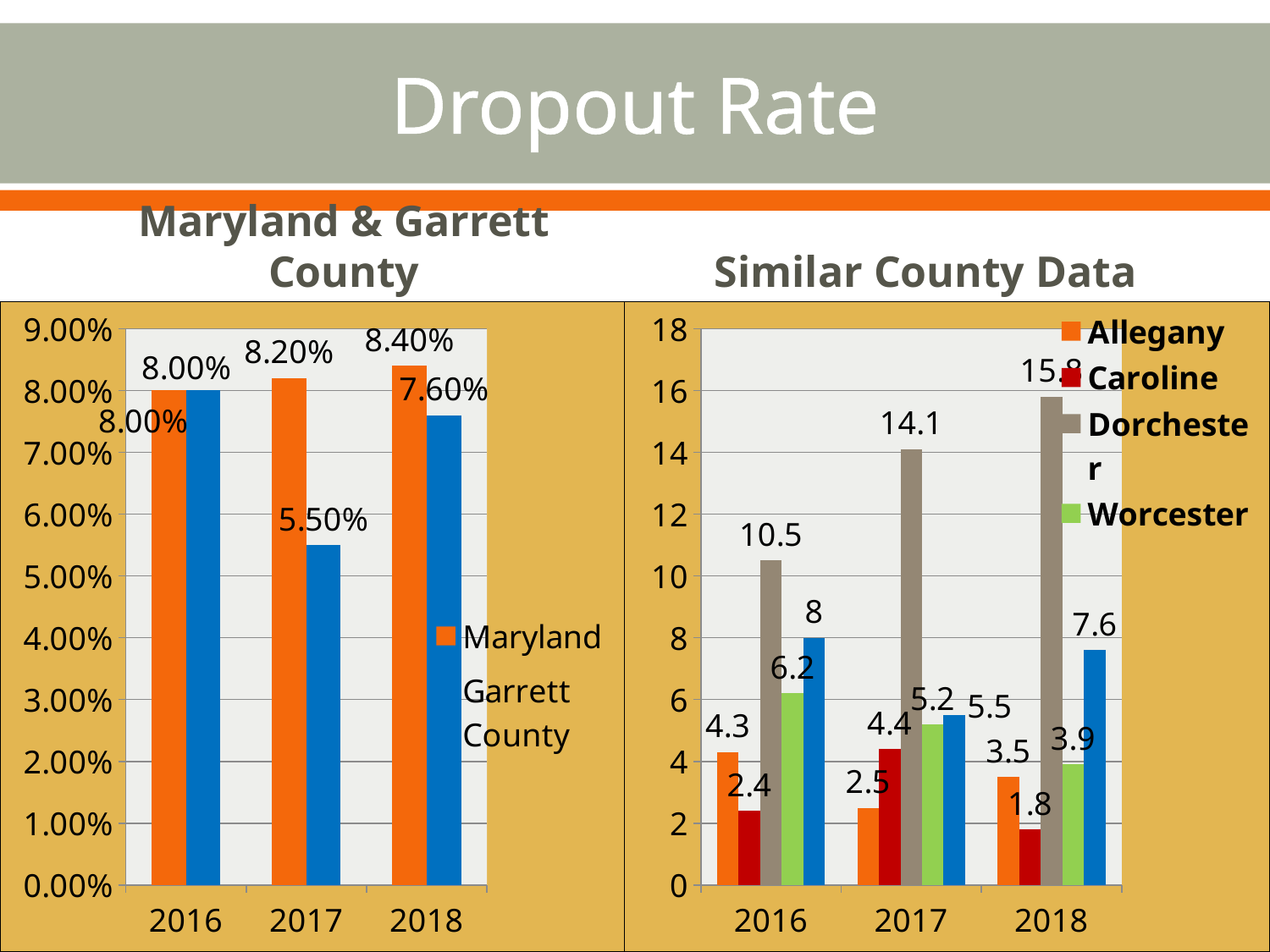
In the Similar County Data chart, which county has the highest value in 2018? Dorchester In the Similar County Data chart, what is the Caroline value for 2018? 1.8 What kind of chart is the Similar County Data chart? bar chart In the Maryland & Garrett County chart, do the Maryland values rise or fall from 2016 to 2018? rise In the Similar County Data chart, what is the Dorchester value for 2017? 14.1 In the Maryland & Garrett County chart, in which year is the Garrett County value lowest? 2017 How many series does the legend of the Maryland & Garrett County chart list? 2 In the Maryland & Garrett County chart, what is the Garrett County value for 2017? 5.50% In the Similar County Data chart, what is the difference between the Dorchester values for 2018 and 2016? 5.3 In the Maryland & Garrett County chart, what is the difference between the Maryland and Garrett County values in 2017? 2.70% In the Maryland & Garrett County chart, what is the Maryland dropout rate for 2018? 8.40% In the Similar County Data chart, which is larger in 2016, Allegany or Worcester? Worcester